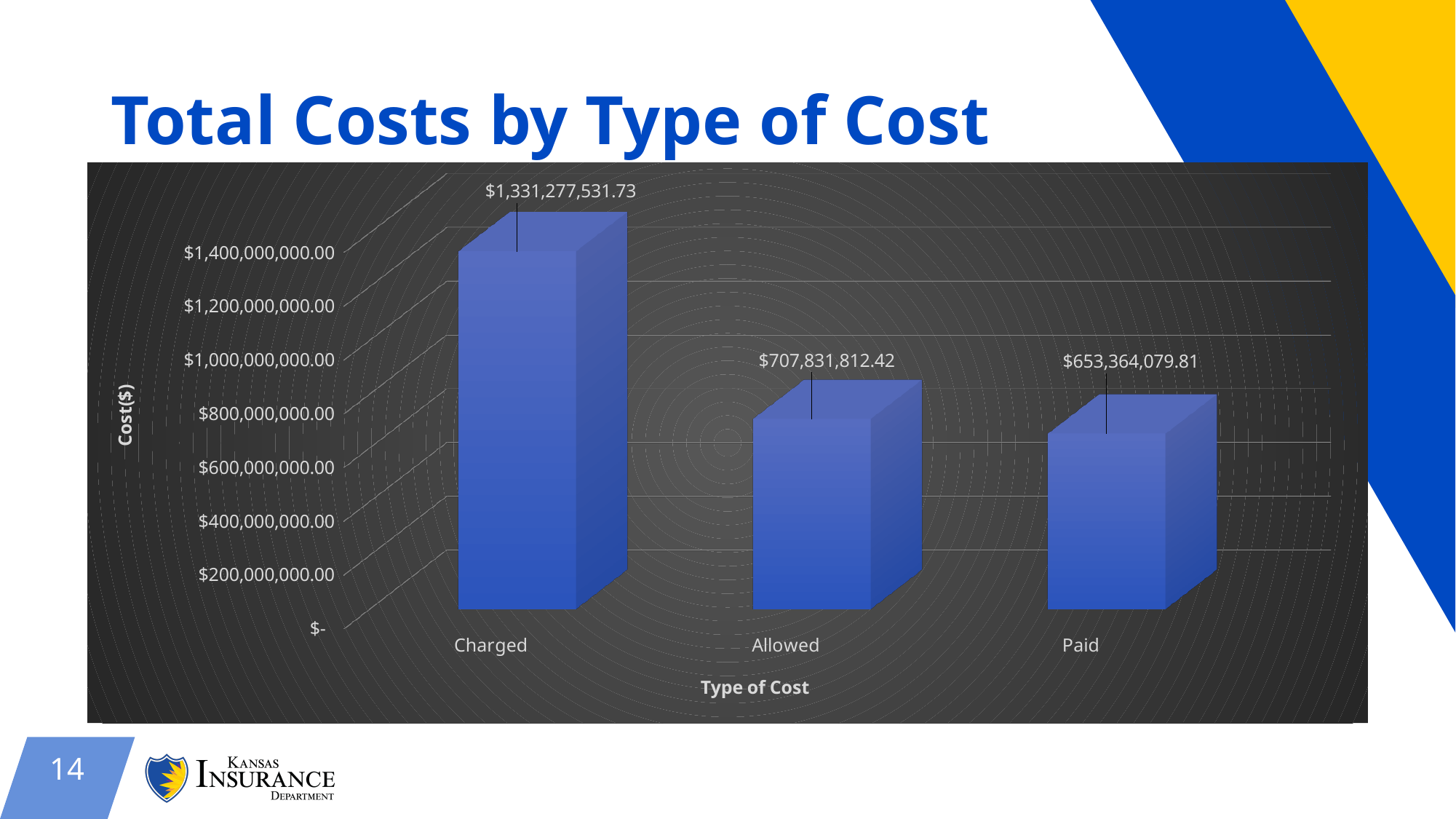
Which type of cost has the lowest total? Paid Which type of cost has the highest total? Charged Is the value for Charged greater or less than $1,200,000,000.00? greater What kind of chart is shown on the slide? Bar chart What is the difference between the Allowed and Paid values? $54,467,732.61 Do the values rise or fall from left to right along the x axis? Fall What is the value for Charged? $1,331,277,531.73 What is the value for Paid? $653,364,079.81 What is the difference between the Charged and Allowed values? $623,445,719.31 What is the value for Allowed? $707,831,812.42 Which is larger, the value for Allowed or the value for Paid? Allowed How many types of cost are shown on the x axis? 3